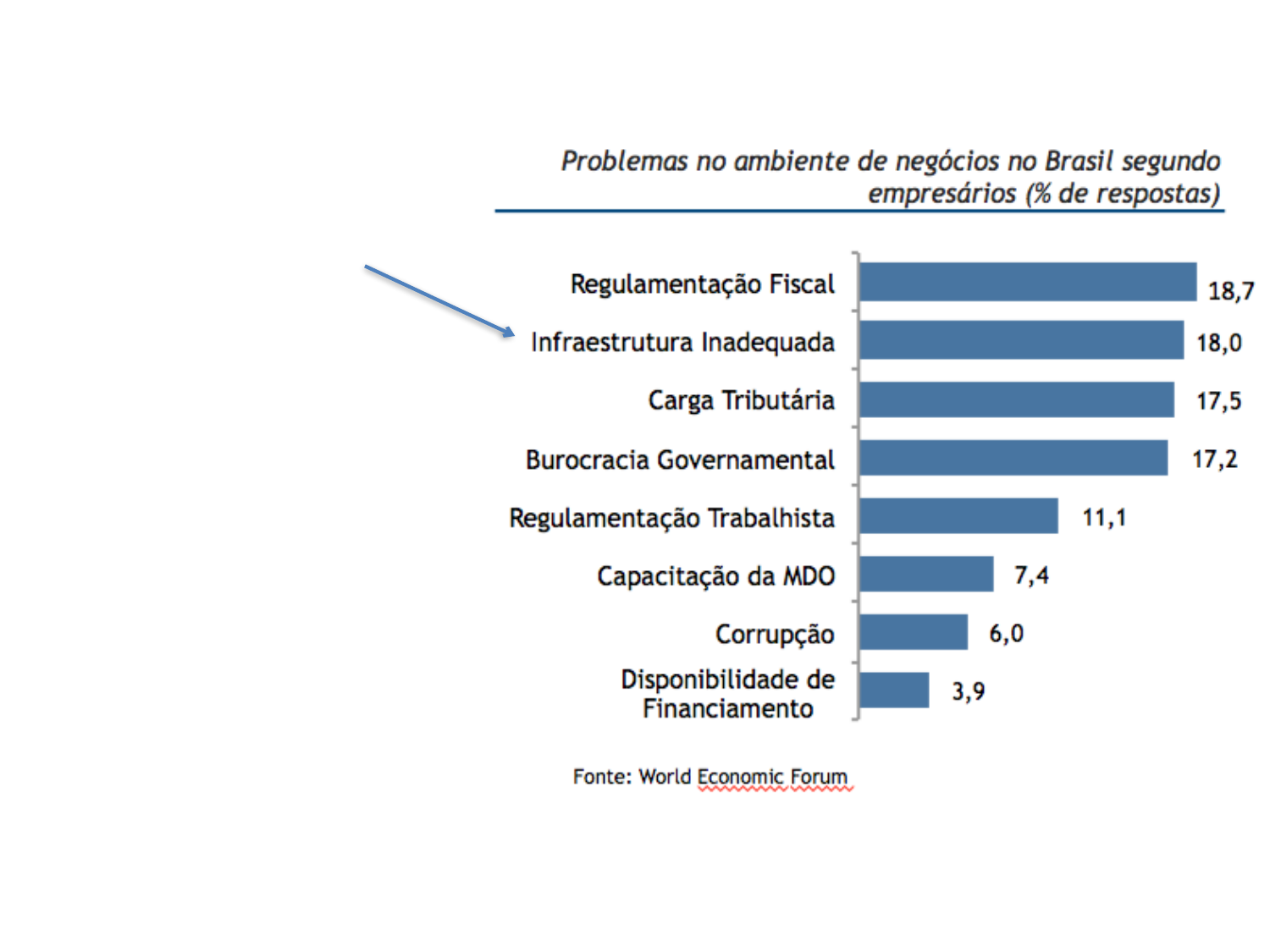
What is the value for Corrupção? 6,0 What is the title of the chart? Problemas no ambiente de negócios no Brasil segundo empresários (% de respostas) How many categories are shown in the chart? 8 Which category has the lowest value? Disponibilidade de Financiamento What is the value for Disponibilidade de Financiamento? 3,9 What source is cited below the chart? World Economic Forum What is the value for Regulamentação Fiscal? 18,7 What kind of chart is shown on the slide? Bar chart Which category has the highest value? Regulamentação Fiscal Which is larger, the value for Carga Tributária or the value for Burocracia Governamental? Carga Tributária What is the value for Infraestrutura Inadequada? 18,0 What is the difference between the values for Regulamentação Trabalhista and Capacitação da MDO? 3,7